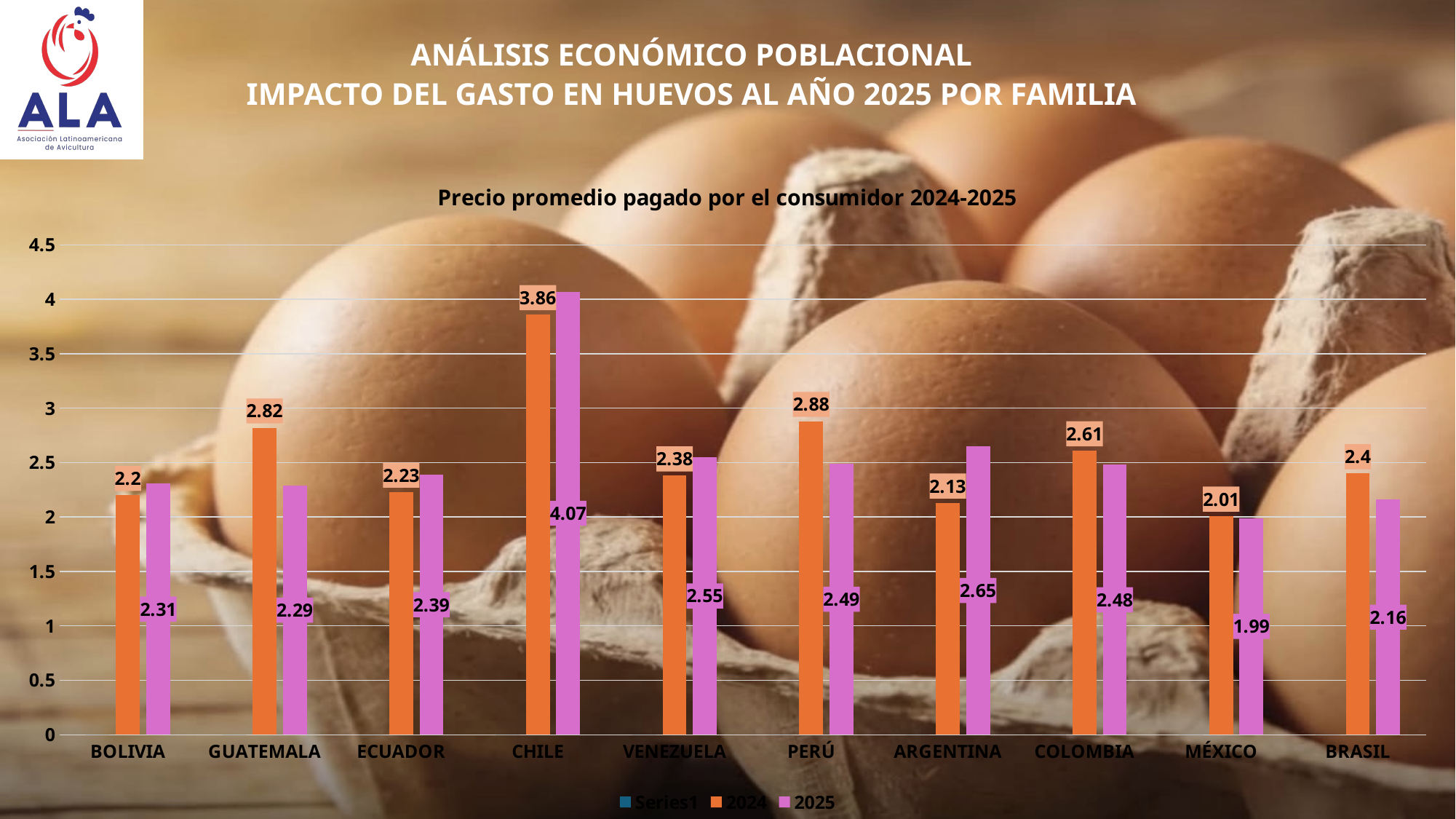
How many series does the legend list? 3 What is the 2025 value for BRASIL? 2.16 What is the 2024 value for MÉXICO? 2.01 What is the difference between the 2025 and 2024 values for CHILE? 0.21 What kind of chart is shown on the slide? Bar chart How many countries are shown on the x axis? 10 Which country has the highest 2025 value? CHILE What is the 2024 value for CHILE? 3.86 What is the 2025 value for ARGENTINA? 2.65 Which country has the lowest 2024 value? MÉXICO Which is larger for GUATEMALA, the 2024 value or the 2025 value? 2024 What is the title of the chart? Precio promedio pagado por el consumidor 2024-2025